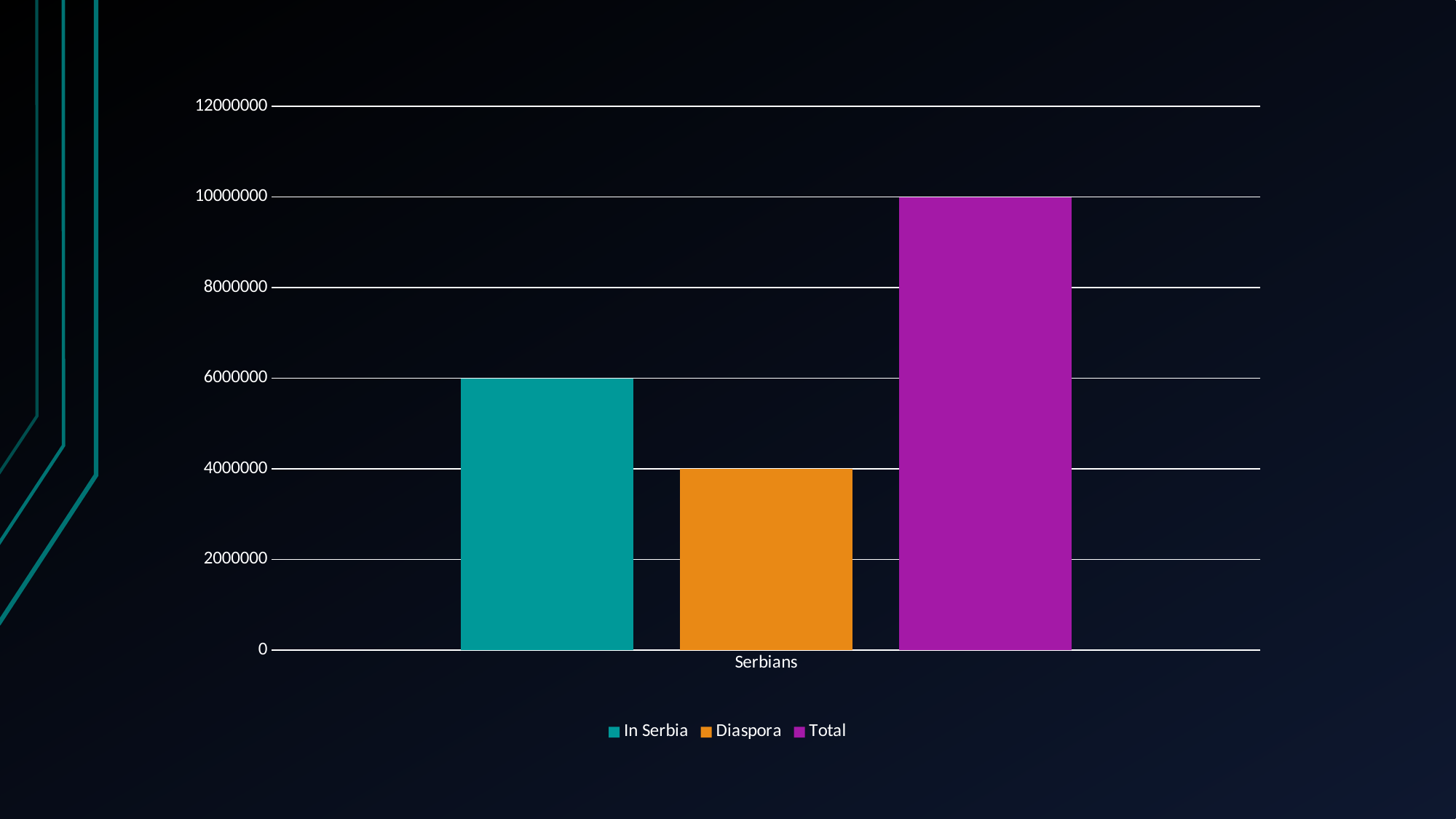
Which is larger, the In Serbia value or the Diaspora value? In Serbia Which series has the highest value? Total How many categories are shown on the x axis? 1 Is the value for Total greater or less than 8000000? greater What is the category label shown on the x axis? Serbians What kind of chart is shown on the slide? bar chart What is the value of the Diaspora bar for Serbians? 4000000 How many series does the legend list? 3 Which series has the lowest value? Diaspora